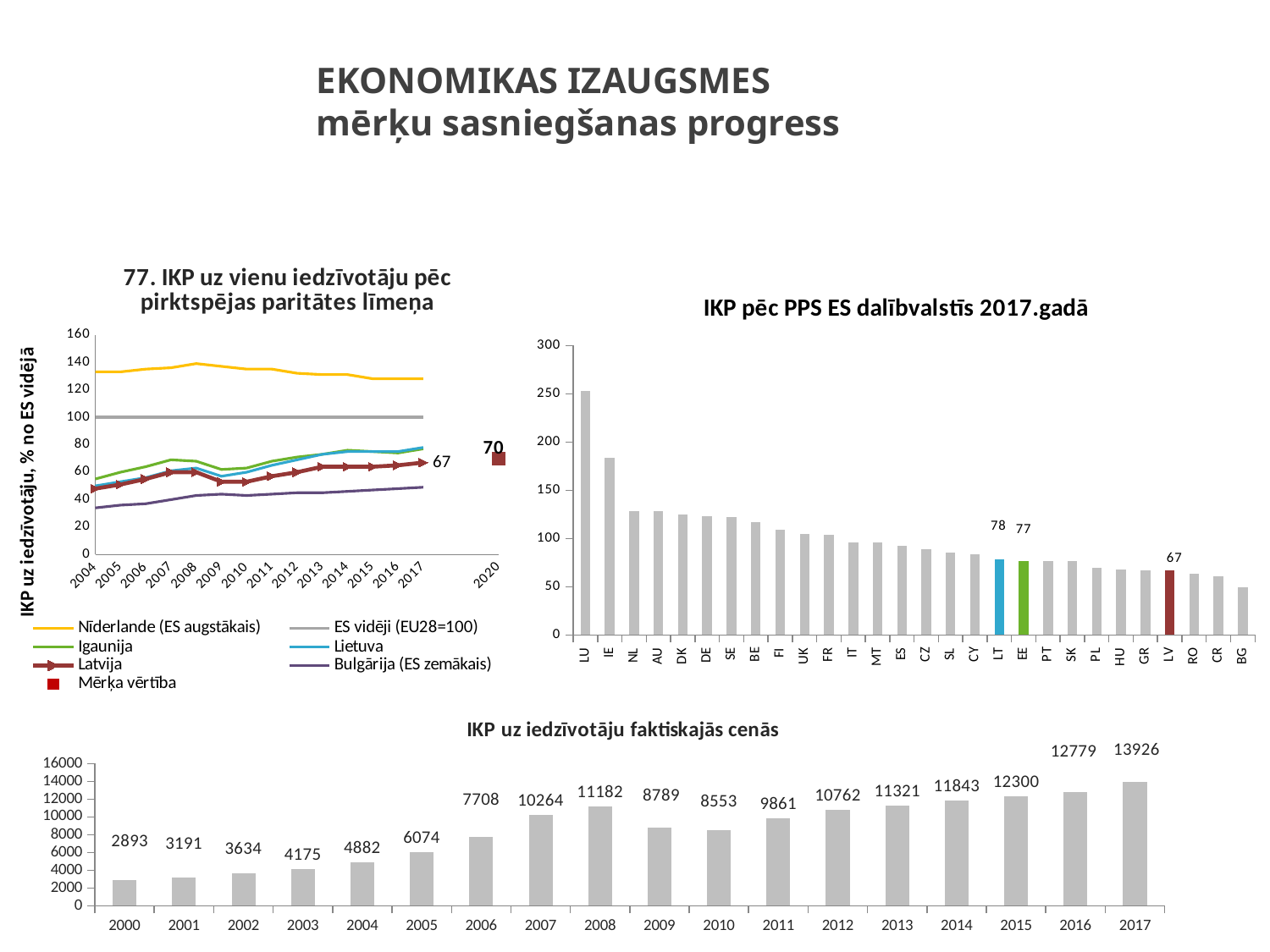
How many series does the legend of the top-left chart '77. IKP uz vienu iedzīvotāju pēc pirktspējas paritātes līmeņa' list? 7 In the top-right chart 'IKP pēc PPS ES dalībvalstīs 2017.gadā', what is the value for LV? 67 How many years are shown in the bottom chart 'IKP uz iedzīvotāju faktiskajās cenās'? 18 In the bottom chart 'IKP uz iedzīvotāju faktiskajās cenās', which year has the larger value, 2008 or 2009? 2008 In the top-right chart 'IKP pēc PPS ES dalībvalstīs 2017.gadā', what is the difference between the values for LT and EE? 1 What kind of chart is the top-left chart '77. IKP uz vienu iedzīvotāju pēc pirktspējas paritātes līmeņa'? line chart In the bottom chart 'IKP uz iedzīvotāju faktiskajās cenās', what is the value for 2017? 13926 In the top-right chart 'IKP pēc PPS ES dalībvalstīs 2017.gadā', which country has the highest value? LU In the top-right chart 'IKP pēc PPS ES dalībvalstīs 2017.gadā', is the value for LU greater or less than 200? greater In the bottom chart 'IKP uz iedzīvotāju faktiskajās cenās', which year has the lowest value? 2000 In the bottom chart 'IKP uz iedzīvotāju faktiskajās cenās', what is the difference between the values for 2017 and 2016? 1147 In the top-left chart '77. IKP uz vienu iedzīvotāju pēc pirktspējas paritātes līmeņa', what is the value of Mērķa vērtība for 2020? 70